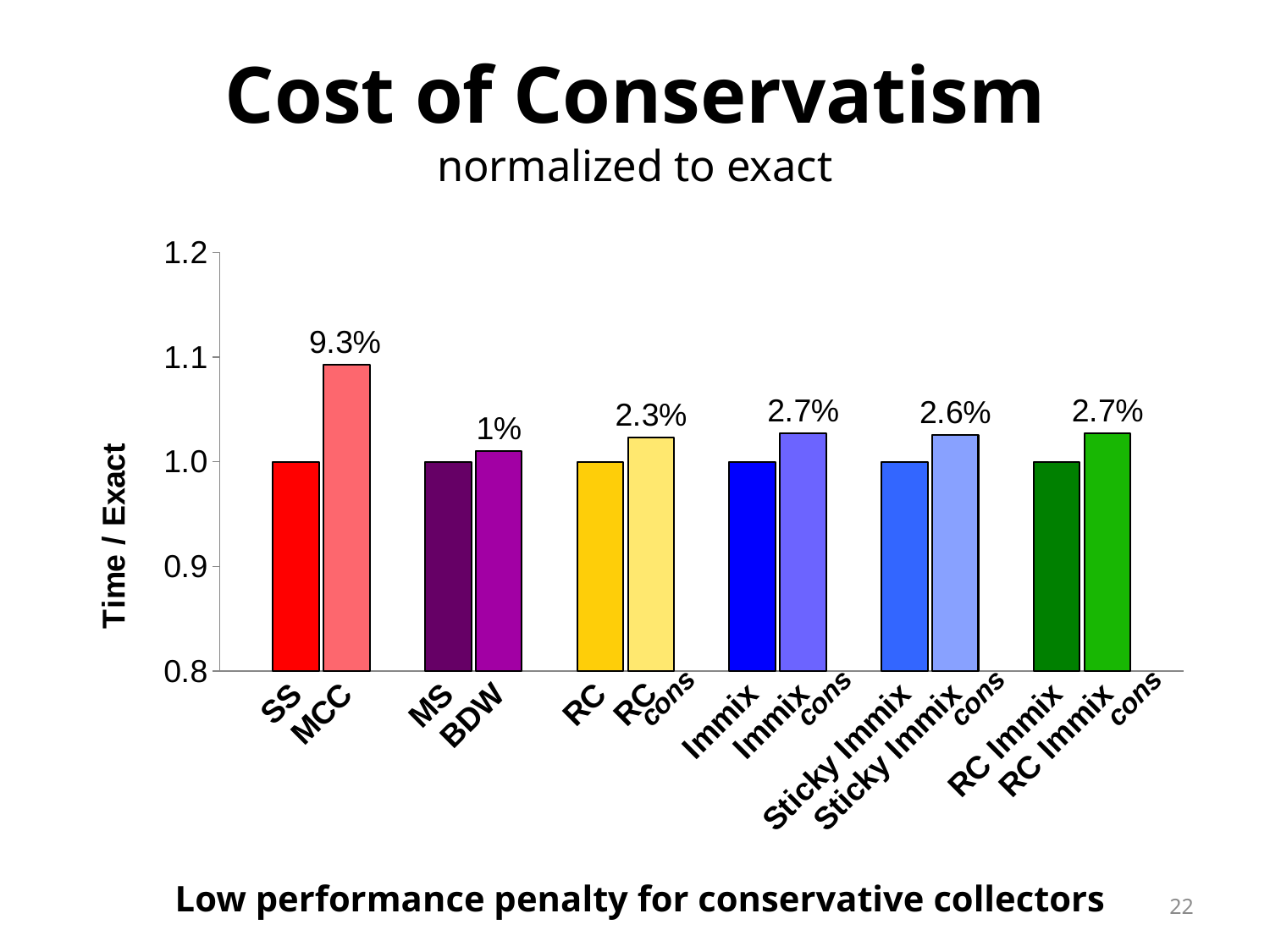
What percentage label is shown above the MCC bar? 9.3% What percentage label is shown above the RC cons bar? 2.3% What is the label of the vertical axis? Time / Exact Is the Time / Exact value for MCC greater or less than 1.1? less What percentage label is shown above the Sticky Immix cons bar? 2.6% What percentage label is shown above the BDW bar? 1% How many bars are plotted in the chart? 12 Among the bars with percentage labels, which has the smallest percentage? BDW Which bar has the highest Time / Exact value? MCC What type of chart is shown on the slide? Bar chart Which bar is taller, MCC or Immix cons? MCC Is the Time / Exact value for RC Immix cons greater or less than 1.0? greater